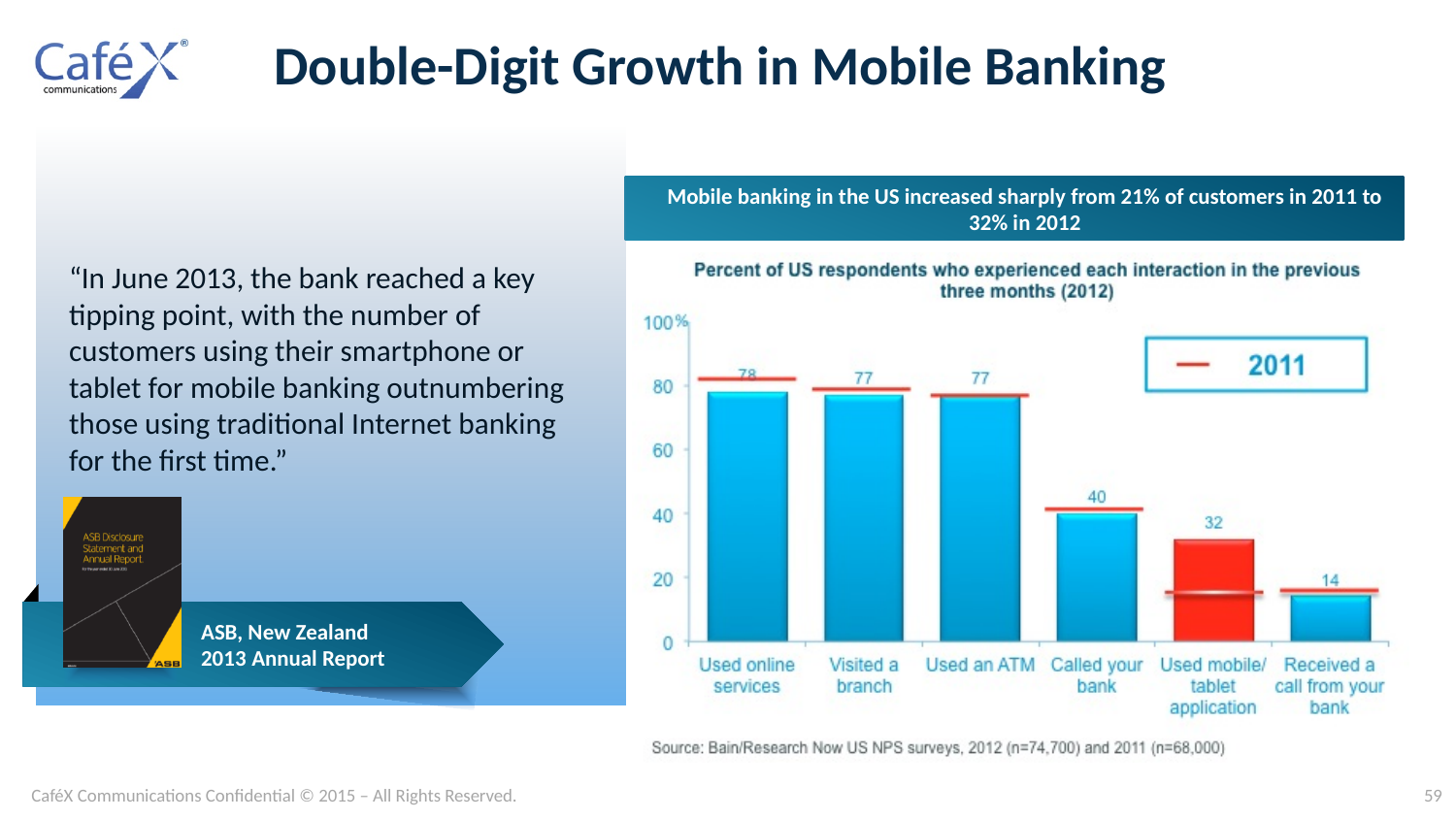
What is the difference between the values for 'Called your bank' and 'Used mobile/tablet application'? 8 What is the value for 'Used online services' in the chart? 78 What is the value for 'Used mobile/tablet application' in the chart? 32 Which category has the highest value in the chart? Used online services What is the value for 'Called your bank' in the chart? 40 Which category has the lowest value in the chart? Received a call from your bank Is the value for 'Used an ATM' greater or less than 60? greater How many categories are shown on the x axis of the chart? 6 What kind of chart is shown on the slide? bar chart Which is larger, the value for 'Visited a branch' or the value for 'Called your bank'? Visited a branch What is the value for 'Received a call from your bank' in the chart? 14 What year does the red line marker in the chart legend represent? 2011